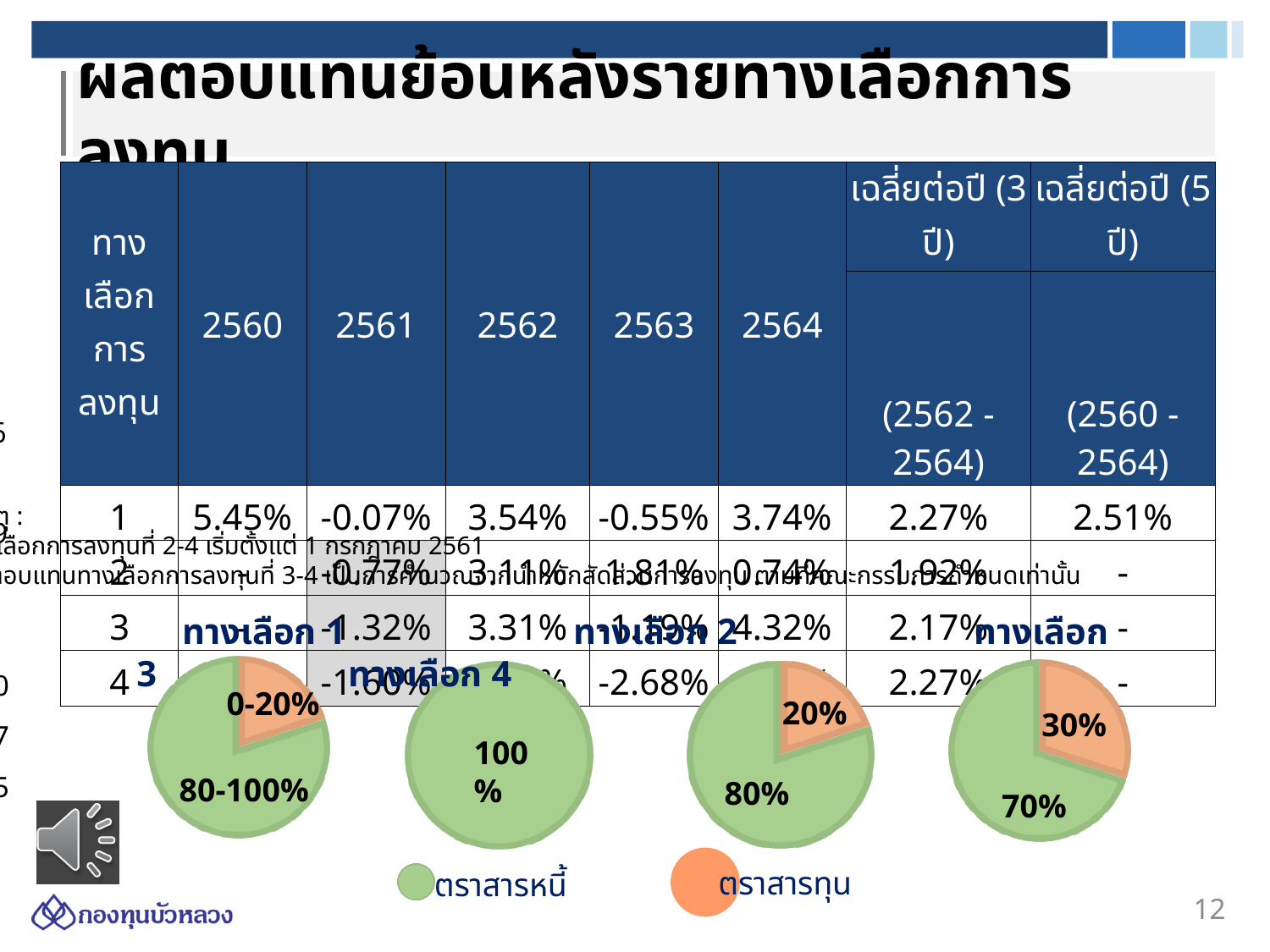
How many pie charts are shown on the slide? 4 In the second pie chart from the left, what value is printed on the green slice? 100% In the leftmost pie chart, what share is shown for ตราสารหนี้ (the green slice)? 80-100% In the rightmost pie chart, what share is shown for ตราสารทุน? 30% In the rightmost pie chart, which slice is larger, ตราสารหนี้ or ตราสารทุน? ตราสารหนี้ In the leftmost pie chart, what share is shown for ตราสารทุน (the orange slice)? 0-20% How many entries does the legend below the pie charts list? 2 What kind of chart is used at the bottom of the slide? Pie chart In the rightmost pie chart, what is the difference between the ตราสารหนี้ share and the ตราสารทุน share? 40%